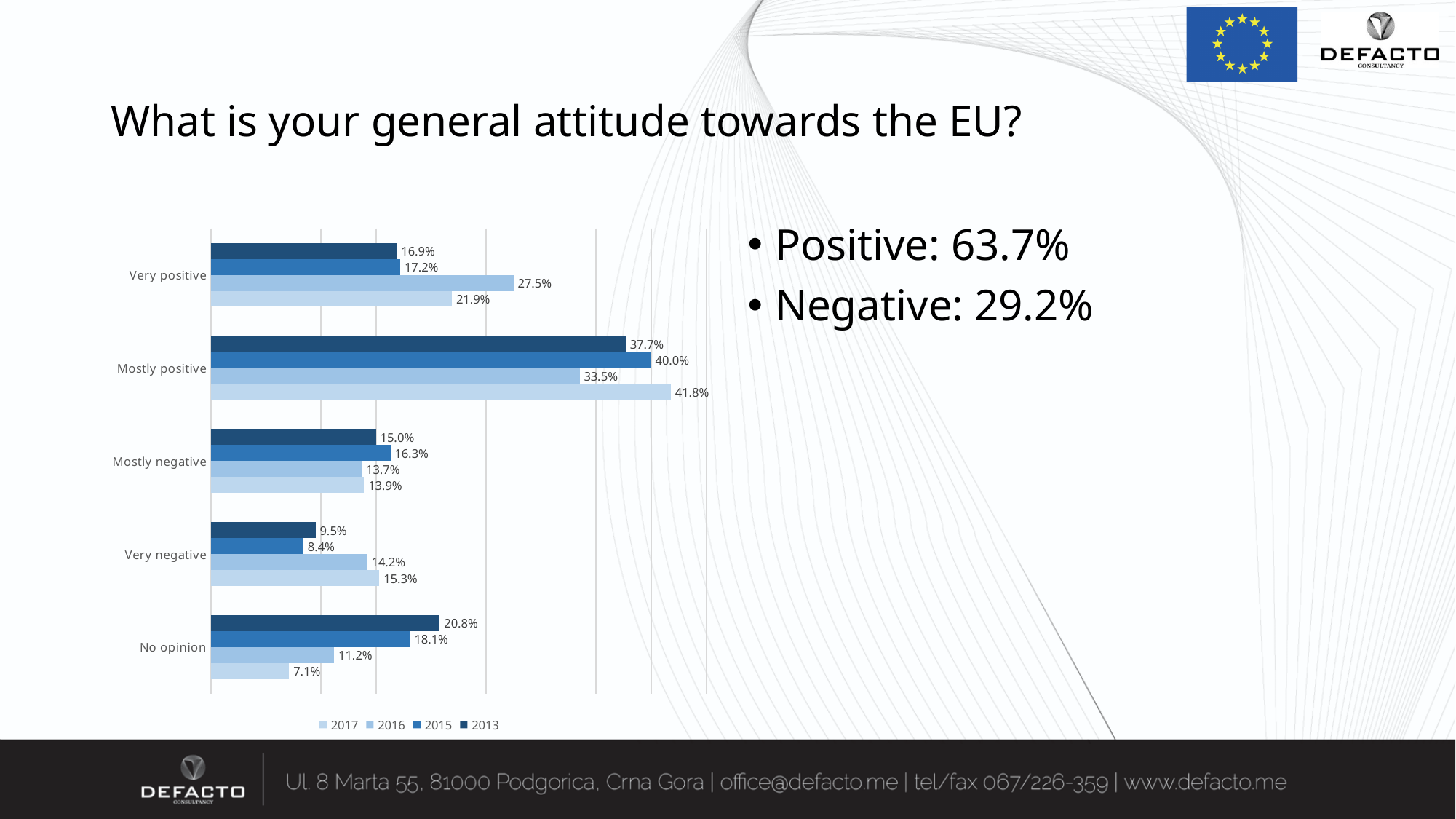
Which response category has the lowest 2017 value? No opinion What is the difference between the 2017 and 2013 values for 'No opinion'? 13.7% Which is larger for 'Very negative': the 2017 value or the 2013 value? 2017 What is the 2015 value for 'Very negative'? 8.4% How many response categories are shown on the chart? 5 How many series does the chart legend list? 4 What is the 2013 value for 'No opinion'? 20.8% What is the 2017 value for 'Mostly positive'? 41.8% What kind of chart is shown on the slide? Bar chart Which years are listed in the chart legend? 2017, 2016, 2015, 2013 Which response category has the highest 2017 value? Mostly positive What is the 2016 value for 'Very positive'? 27.5%